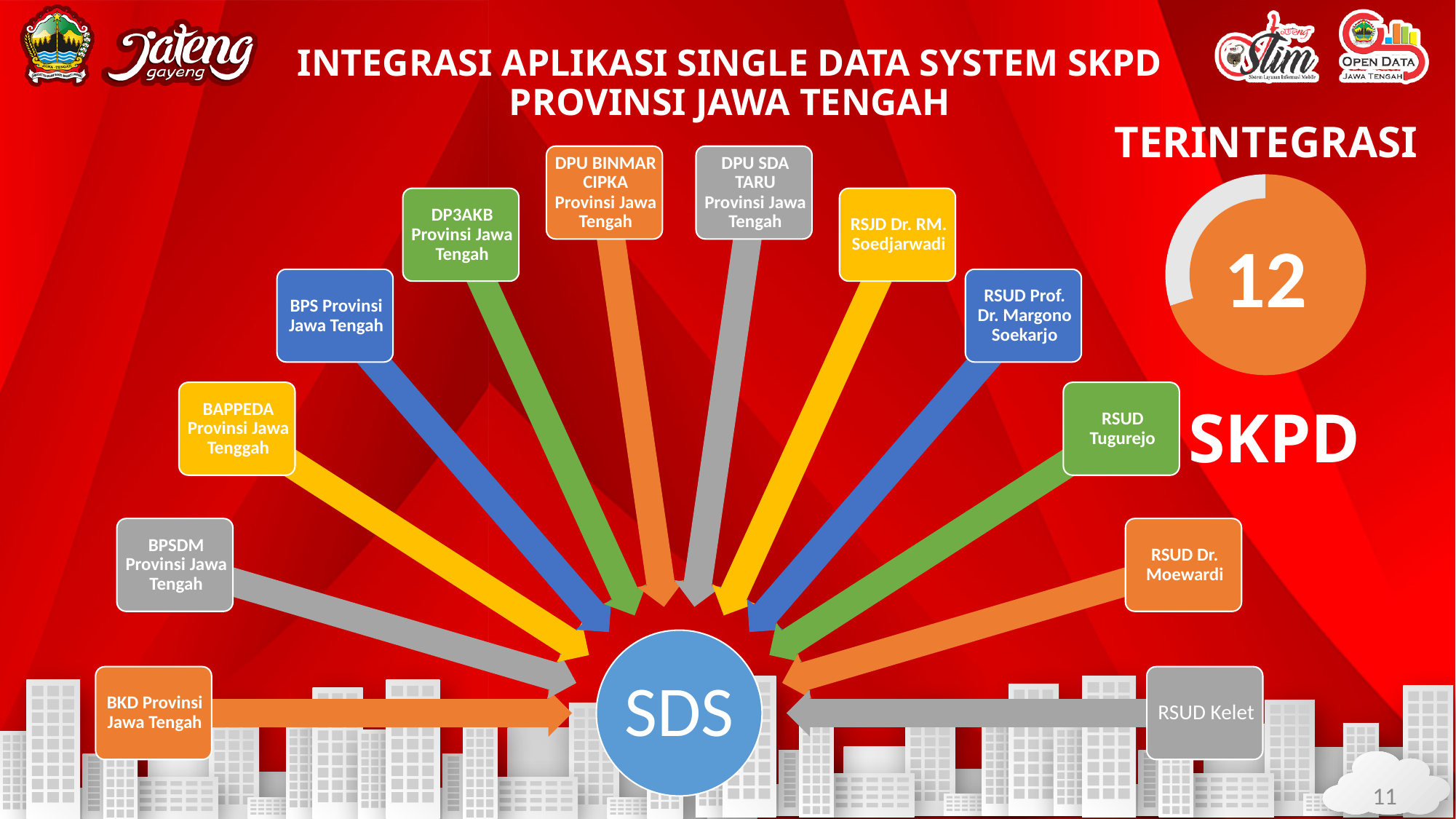
Does the orange filled segment of the doughnut chart cover more or less than half of the ring? more What word appears directly above the doughnut chart? TERINTEGRASI What number is printed in the centre of the doughnut chart on the right of the slide? 12 What word appears directly below the doughnut chart? SKPD How many SKPD boxes point with arrows to the SDS circle in the diagram? 12 What kind of chart is shown on the right side of the slide under the word TERINTEGRASI? doughnut chart